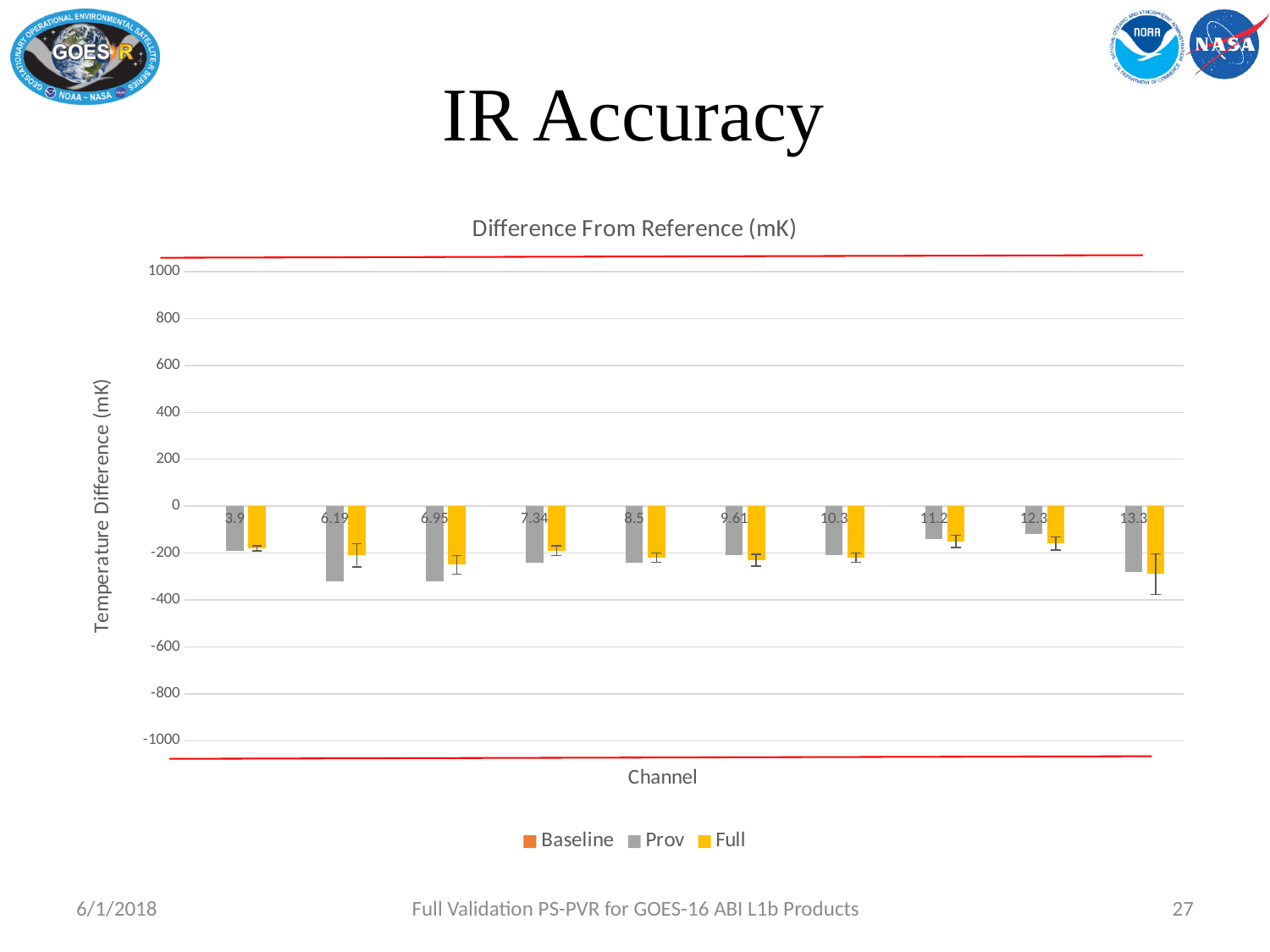
What is the title of the chart? Difference From Reference (mK) How many series does the chart legend list? 3 How many channels are shown along the x axis of the chart? 10 Which is larger, the Full value for channel 3.9 or the Full value for channel 13.3? 3.9 Is the Prov value for channel 11.2 greater or less than -200? greater Which is larger, the Prov value for channel 3.9 or the Prov value for channel 6.19? 3.9 What is the label of the y axis of the chart? Temperature Difference (mK) Is the Full value for channel 13.3 greater or less than -200? less What type of chart is shown on the slide? bar chart Is the Prov value for channel 6.19 greater or less than -200? less Which channel has the lowest Full value? 13.3